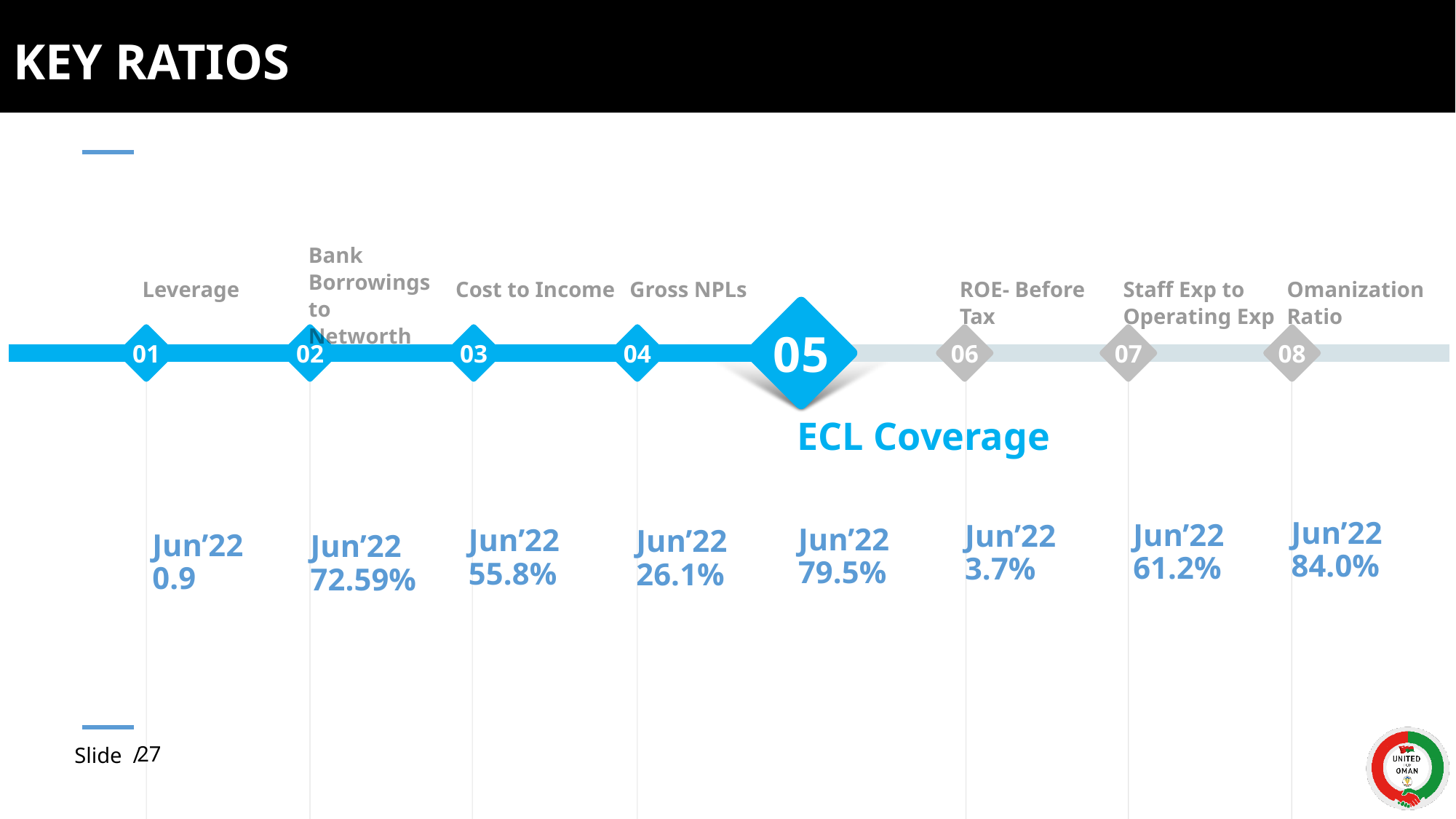
What is the value shown for Bank Borrowings to Networth? 72.59% What is the value shown for Gross NPLs? 26.1% What is the Omanization Ratio shown? 84.0% Which of the percentage ratios has the lowest value? ROE- Before Tax What is the value shown for Leverage? 0.9 What is the value shown for Staff Exp to Operating Exp? 61.2% What is the Cost to Income ratio shown? 55.8% Which ratio is highlighted with the large blue marker (05)? ECL Coverage What is the ECL Coverage value shown? 79.5% Which of the percentage ratios has the highest value? Omanization Ratio What is the value shown for ROE- Before Tax? 3.7% How many key ratios are shown on the slide? 8